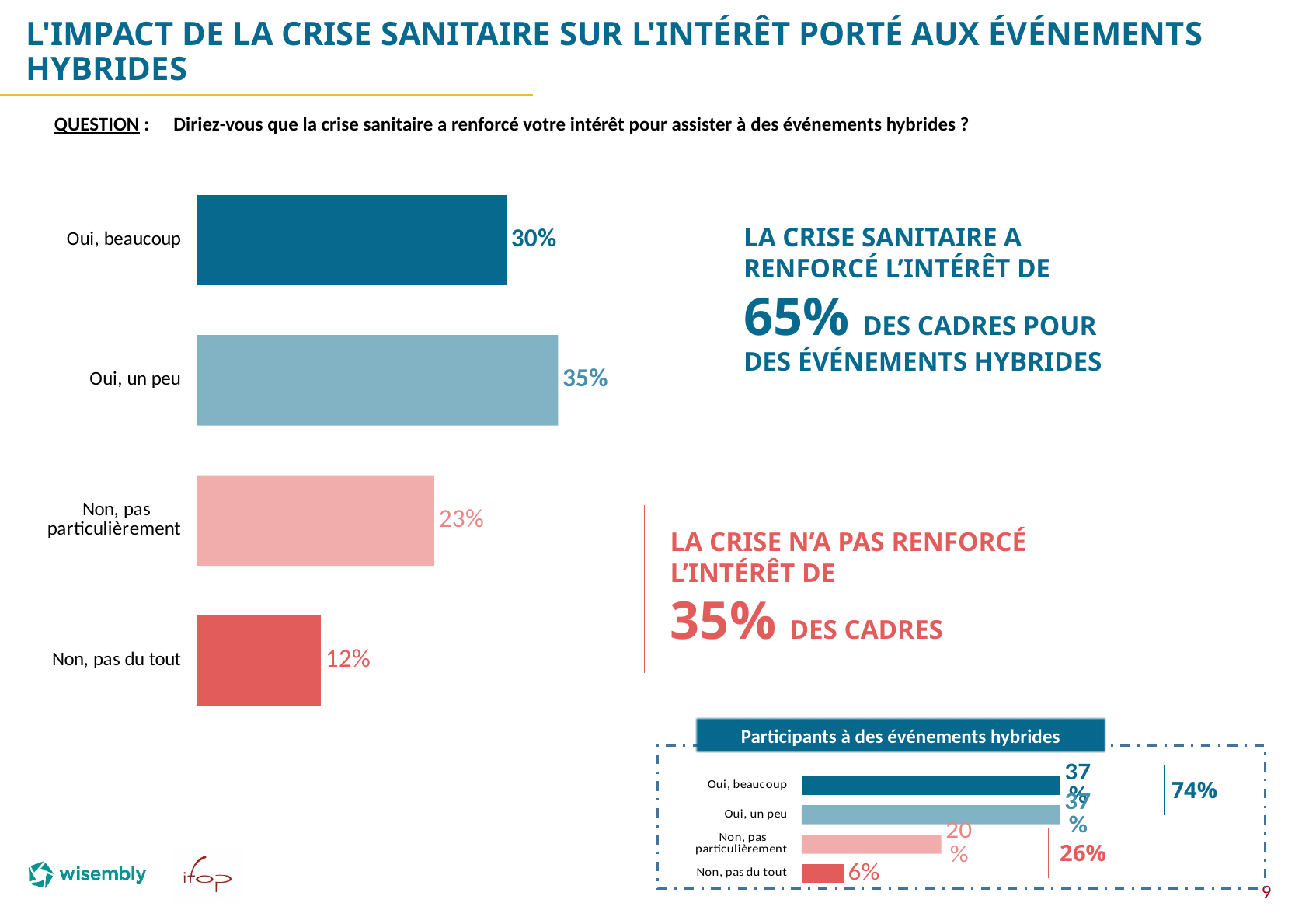
On the main chart on the left, which category has the highest value? Oui, un peu On the main chart on the left, which category has the lowest value? Non, pas du tout How many categories does the main chart on the left show? 4 What kind of chart is the main chart on the left? Bar chart On the chart titled "Participants à des événements hybrides", what is the value for "Non, pas du tout"? 6% On the main chart on the left, which is larger: "Oui, beaucoup" or "Non, pas particulièrement"? Oui, beaucoup On the main chart on the left, what is the difference between "Oui, beaucoup" and "Non, pas du tout"? 18% On the main chart on the left, what is the value for "Oui, un peu"? 35% On the main chart on the left, what is the value for "Non, pas particulièrement"? 23% On the chart titled "Participants à des événements hybrides", what is the value for "Non, pas particulièrement"? 20% On the main chart on the left, what is the value for "Non, pas du tout"? 12% On the chart titled "Participants à des événements hybrides", which category has the lowest value? Non, pas du tout